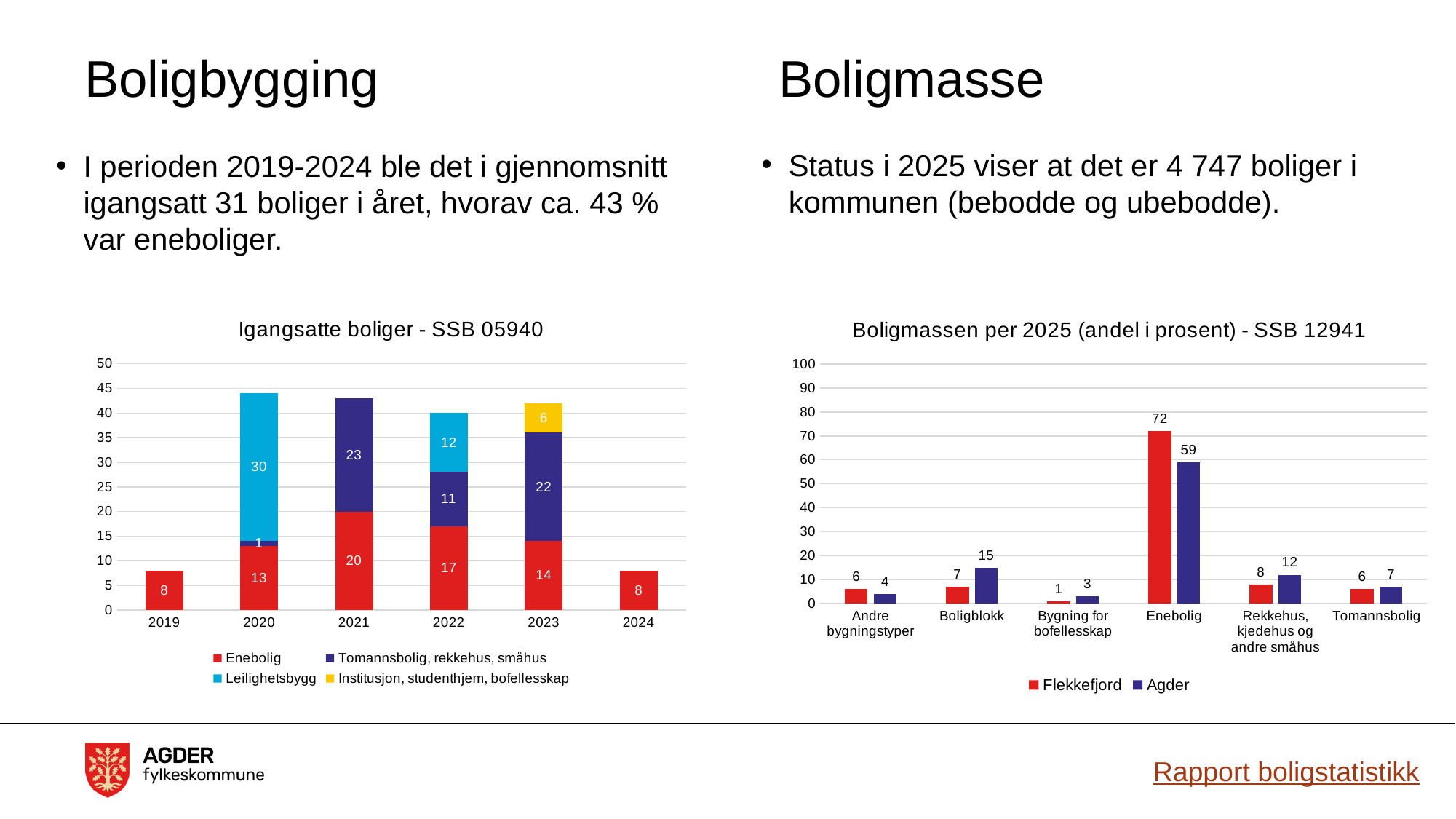
In the chart 'Boligmassen per 2025 (andel i prosent) - SSB 12941', what is the Agder value for Boligblokk? 15 In the chart 'Boligmassen per 2025 (andel i prosent) - SSB 12941', which is larger for Rekkehus, kjedehus og andre småhus: Flekkefjord or Agder? Agder In the chart 'Igangsatte boliger - SSB 05940', what is the total of the stacked bar for 2022? 40 In the chart 'Igangsatte boliger - SSB 05940', how many years are shown on the x axis? 6 In the chart 'Boligmassen per 2025 (andel i prosent) - SSB 12941', what is the difference between the Flekkefjord and Agder values for Enebolig? 13 In the chart 'Igangsatte boliger - SSB 05940', what is the total of the stacked bar for 2020? 44 What kind of chart is 'Boligmassen per 2025 (andel i prosent) - SSB 12941'? Bar chart In the chart 'Boligmassen per 2025 (andel i prosent) - SSB 12941', what is the Flekkefjord value for Enebolig? 72 In the chart 'Boligmassen per 2025 (andel i prosent) - SSB 12941', which category has the lowest Flekkefjord value? Bygning for bofellesskap In the chart 'Igangsatte boliger - SSB 05940', what is the Leilighetsbygg value for 2020? 30 In the chart 'Igangsatte boliger - SSB 05940', what is the Enebolig value for 2021? 20 In the chart 'Igangsatte boliger - SSB 05940', how many series does the legend list? 4